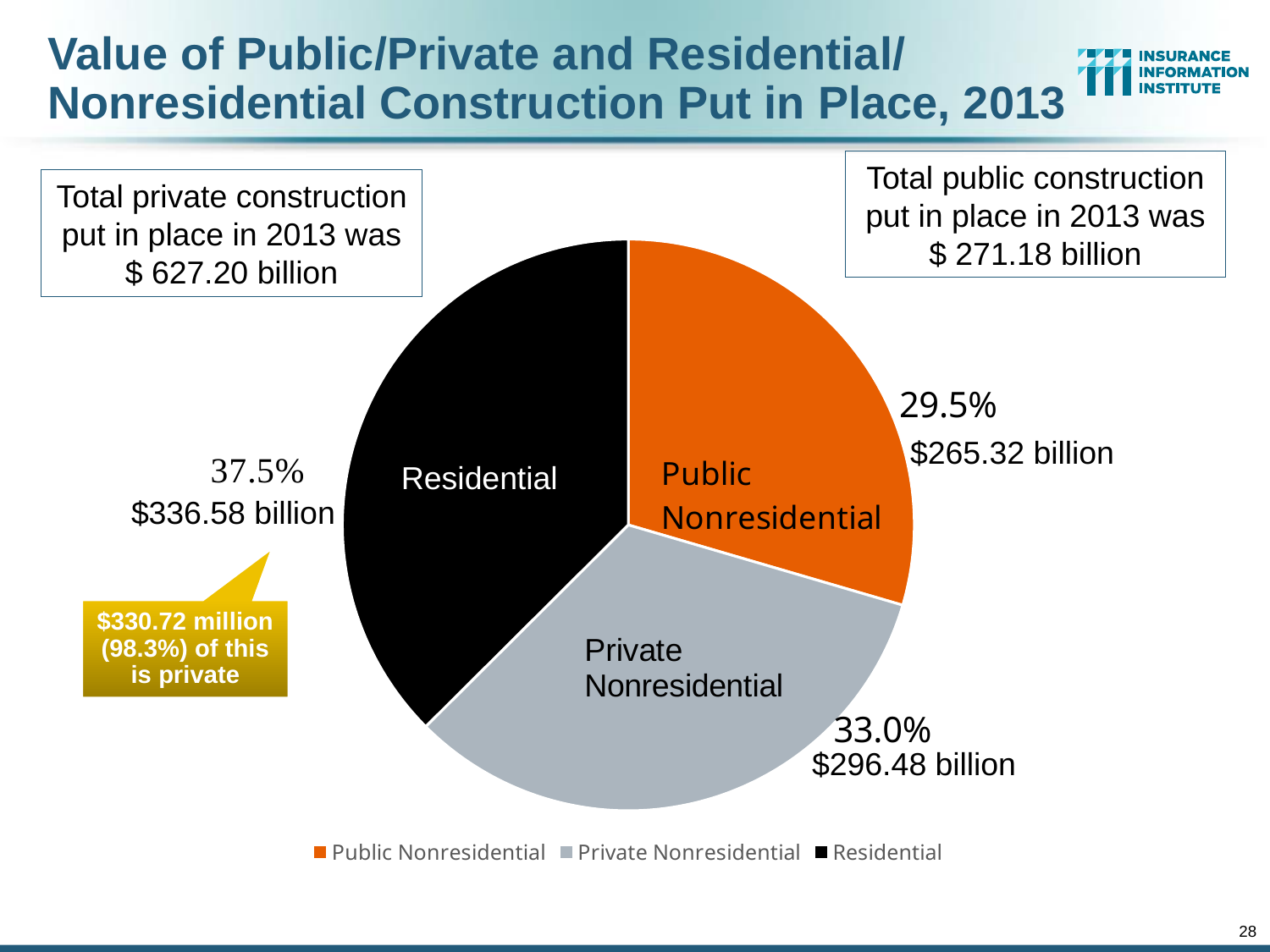
What is the difference in value between the Residential and Public Nonresidential slices? $71.26 billion What is the value shown for the Private Nonresidential slice? $296.48 billion Which slice of the pie is the largest? Residential How many slices does the pie chart have? 3 What kind of chart is shown on the slide? Pie chart Which colour represents the Public Nonresidential slice in the pie chart? Orange What share of the pie does the Private Nonresidential slice represent? 33.0% What is the value shown for the Public Nonresidential slice? $265.32 billion What share of the pie does the Residential slice represent? 37.5% What is the value shown for the Residential slice? $336.58 billion Which slice of the pie is the smallest? Public Nonresidential How many entries does the legend list? 3